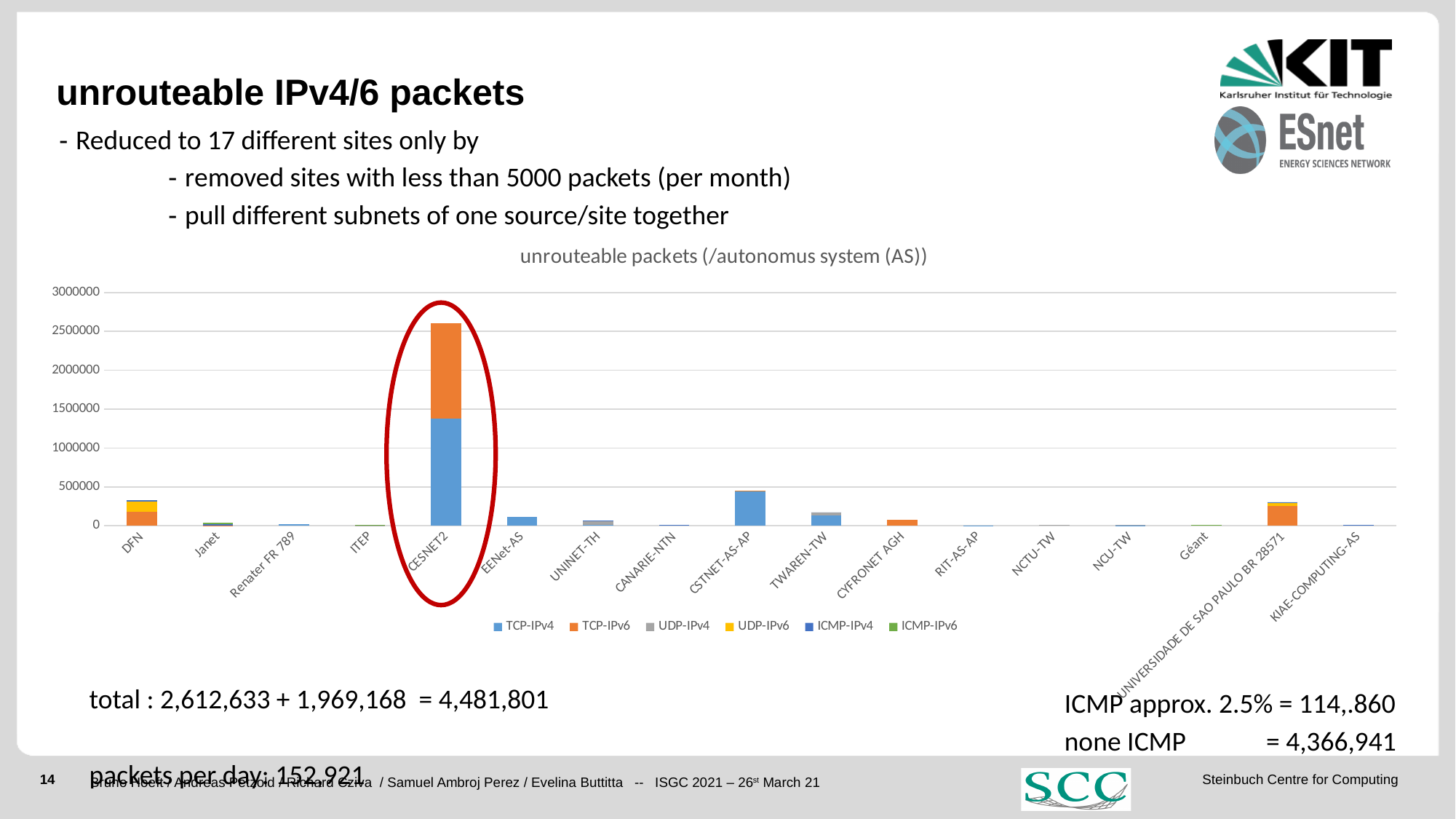
Which has the larger total of unrouteable packets, CSTNET-AS-AP or DFN? CSTNET-AS-AP Is the total value for CESNET2 greater or less than 2000000? greater How many series does the chart legend list? 6 Which has the larger total of unrouteable packets, CESNET2 or CSTNET-AS-AP? CESNET2 Is the total value for DFN greater or less than 500000? less Which category has the highest total of unrouteable packets in the chart? CESNET2 Is the total value for TWAREN-TW greater or less than 500000? less Which category on the chart is highlighted with a red circle? CESNET2 What kind of chart is shown on the slide? stacked bar chart What is the title of the chart? unrouteable packets (/autonomus system (AS)) How many categories (autonomous systems) are shown on the x axis of the chart? 17